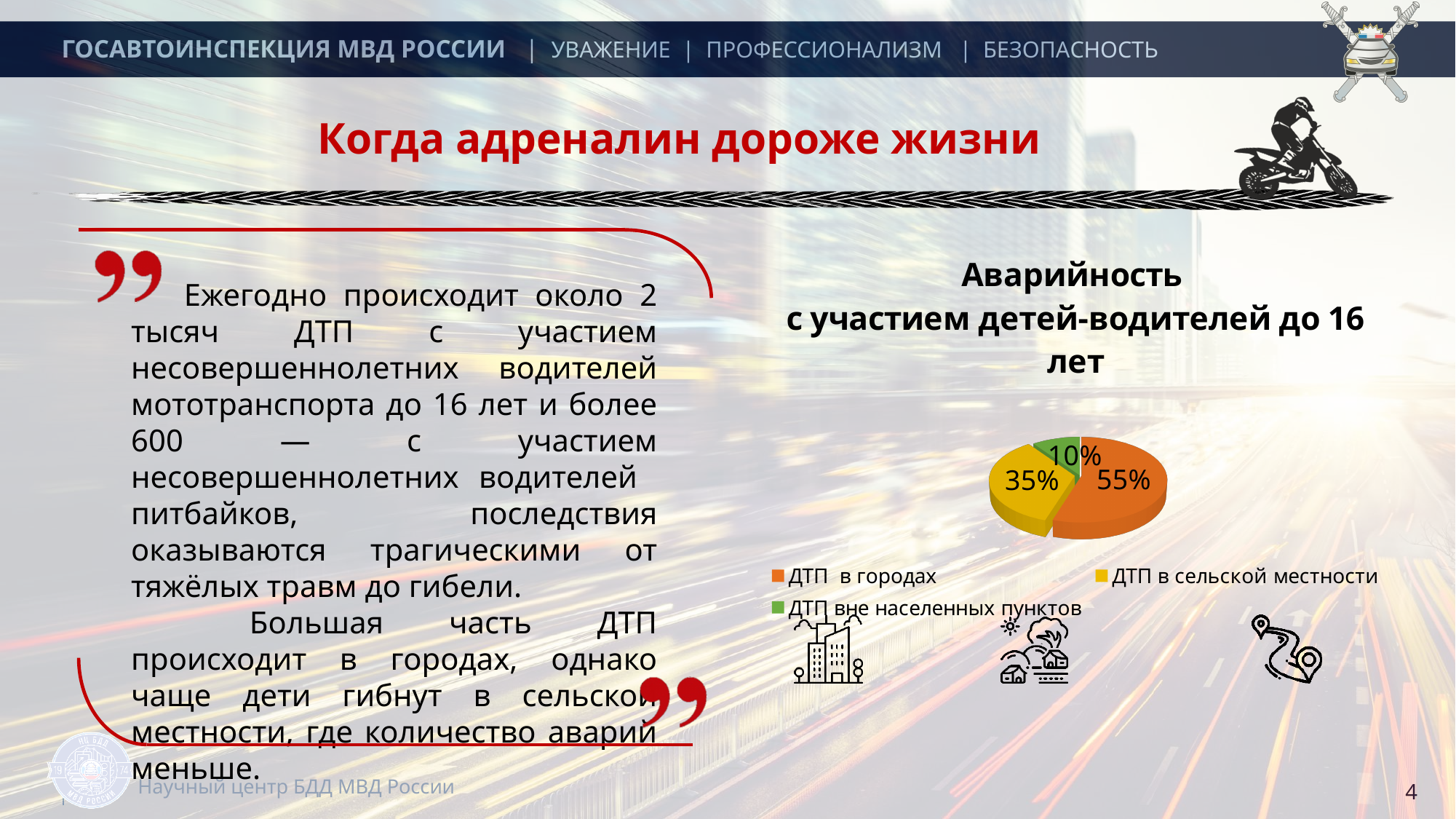
Which is larger: the "ДТП в сельской местности" slice or the "ДТП вне населенных пунктов" slice? ДТП в сельской местности What share of the pie chart is labelled "ДТП в городах"? 55% How many slices does the pie chart have? 3 What colour is the "ДТП в городах" slice in the pie chart? orange What kind of chart is shown on the slide? pie chart What is the title of the pie chart? Аварийность с участием детей-водителей до 16 лет How many entries does the legend of the pie chart list? 3 Which category has the smallest slice of the pie chart? ДТП вне населенных пунктов What share of the pie chart is labelled "ДТП в сельской местности"? 35% What share of the pie chart is labelled "ДТП вне населенных пунктов"? 10% Which category has the largest slice of the pie chart? ДТП в городах What is the difference in percentage points between the "ДТП в городах" slice and the "ДТП в сельской местности" slice? 20